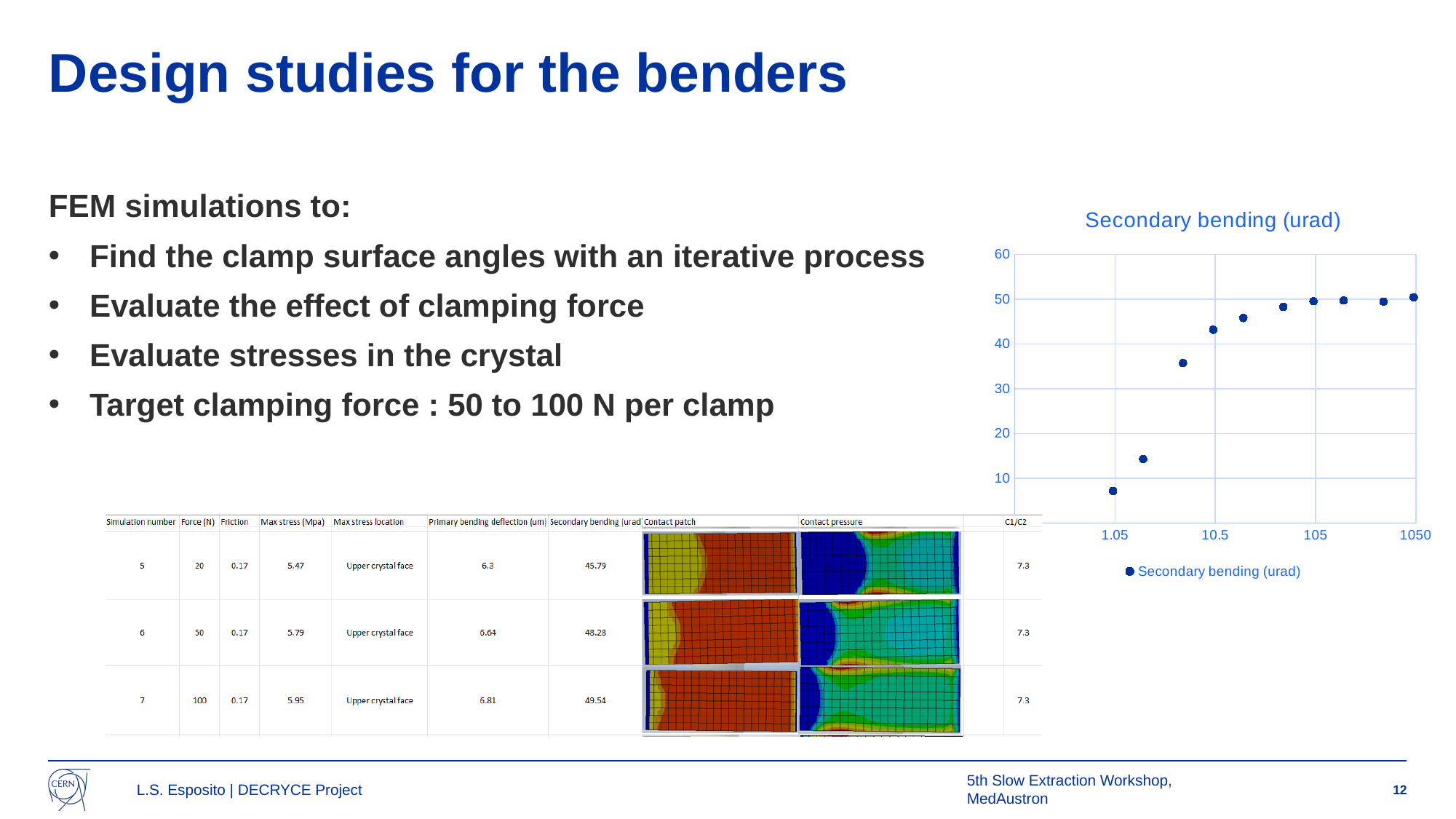
Is the value of the point at x = 10.5 greater or less than 40? greater Is the value of the point at x = 105 greater or less than 40? greater Is the value of the point at x = 1050 greater or less than 40? greater Which point has the larger value, the one at x = 10.5 or the one at x = 105? 105 What kind of chart is shown on the slide? scatter chart Which point has the larger value, the one at x = 1.05 or the one at x = 10.5? 10.5 Do the plotted values rise or fall as the x axis increases? rise What is the legend entry of the chart? Secondary bending (urad) What is the title of the chart? Secondary bending (urad) At which x-axis tick is the lowest plotted value found? 1.05 How many series does the chart legend list? 1